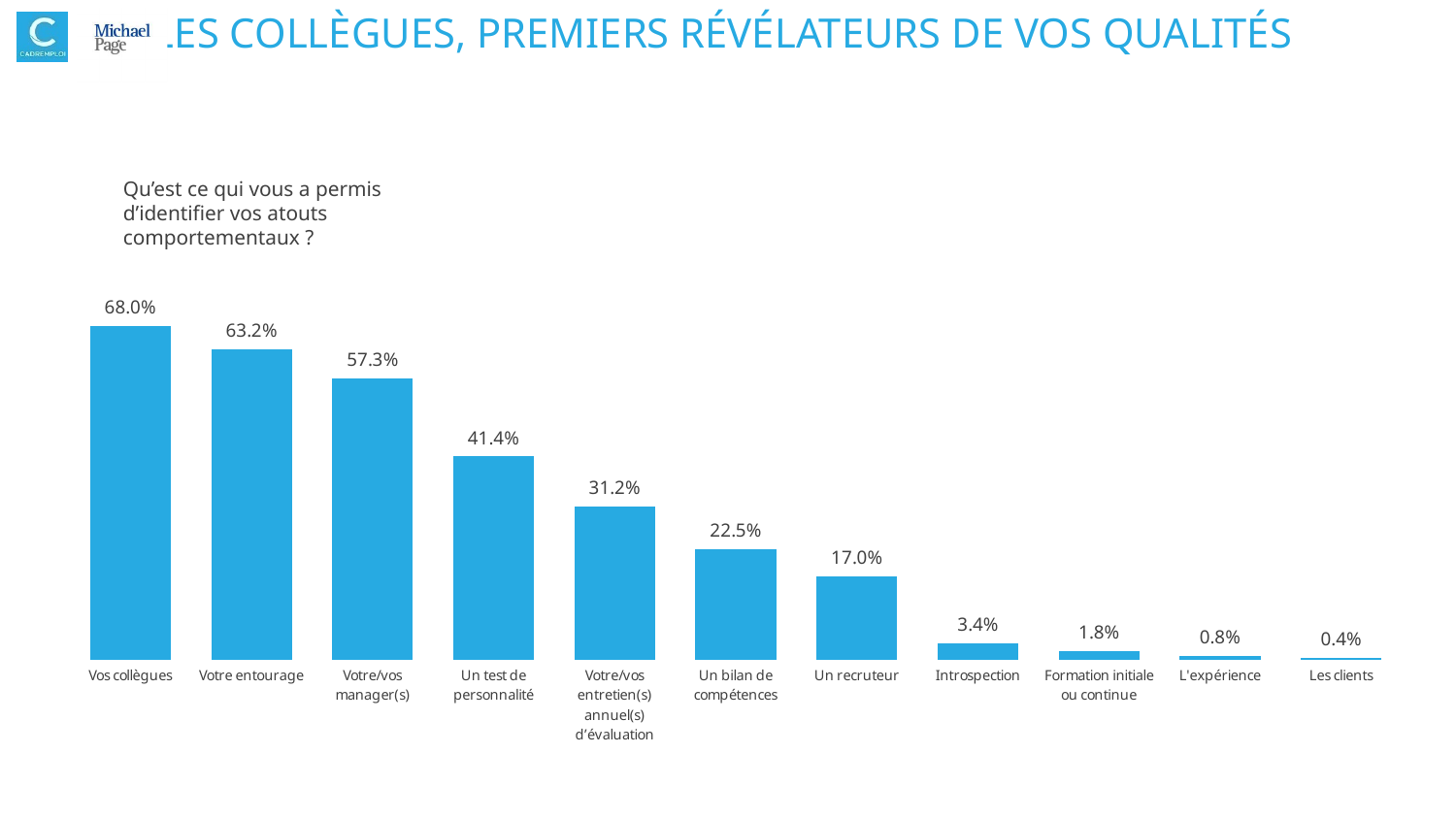
How many categories are shown in the chart? 11 What is the value for "Introspection"? 3.4% What is the value for "Vos collègues"? 68.0% Which category has the highest value? Vos collègues Do the values rise or fall from left to right along the x axis? Fall Which is larger, the value for "Un bilan de compétences" or the value for "Un recruteur"? Un bilan de compétences What is the difference between the values for "Votre entourage" and "Votre/vos manager(s)"? 5.9% What is the value for "Formation initiale ou continue"? 1.8% What is the value for "Un test de personnalité"? 41.4% Which category has the lowest value? Les clients What question is the chart answering, as written above the chart? Qu'est ce qui vous a permis d'identifier vos atouts comportementaux ? What kind of chart is shown on the slide? Bar chart